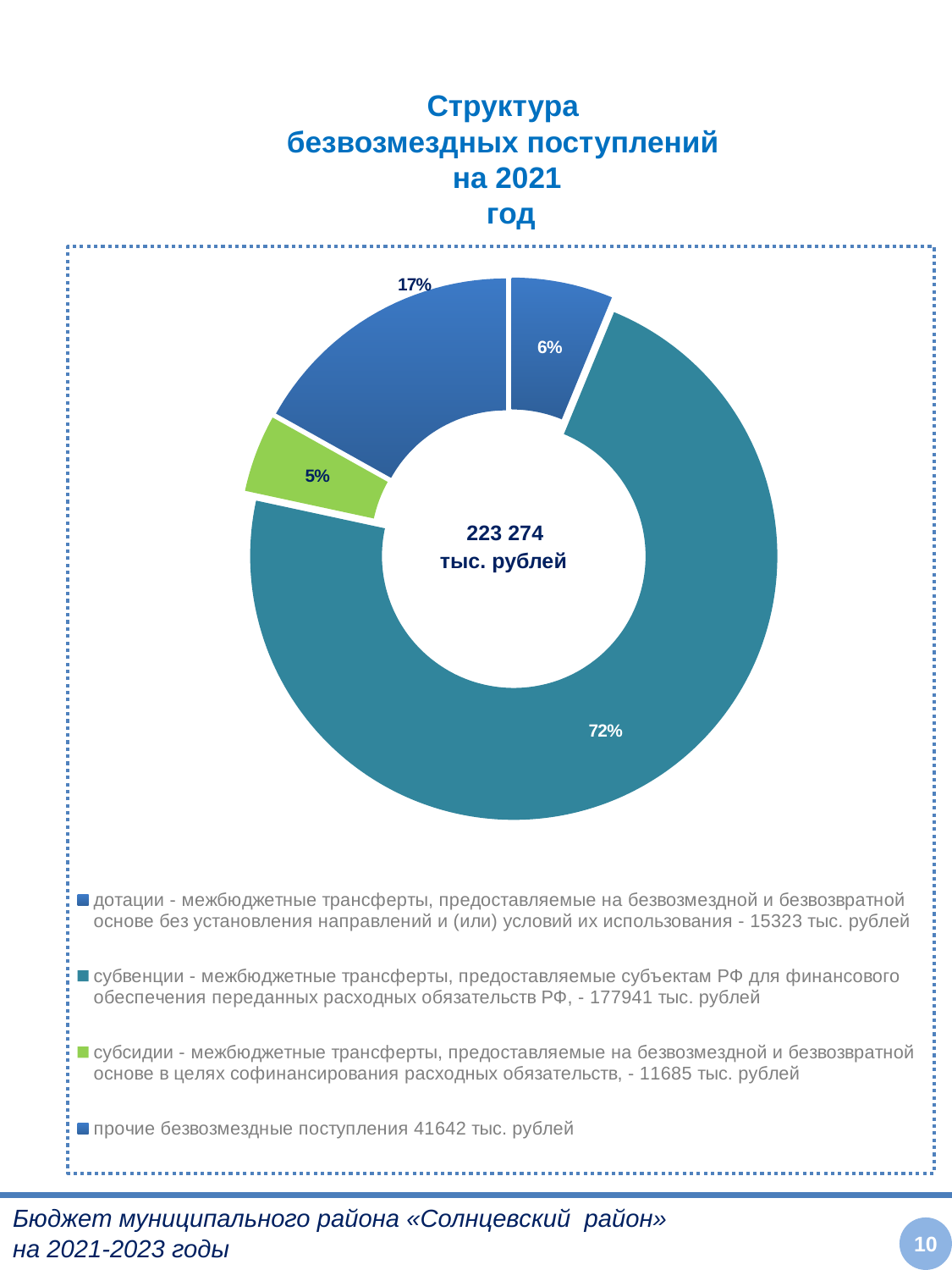
What share of the chart is labelled for дотации (the dark blue slice at the top)? 6% What share of the chart is labelled for субвенции (the teal slice)? 72% What share of the chart is labelled for субсидии (the green slice)? 5% How many slices does the doughnut chart have? 4 What is the difference in percentage points between the субвенции slice and the прочие безвозмездные поступления slice? 55 percentage points What kind of chart is shown on the slide? Pie (doughnut) chart What total amount is printed in the centre of the doughnut chart? 223 274 тыс. рублей Which category has the smallest slice in the chart? субсидии Which category has the largest slice in the chart? субвенции According to the legend, what amount is given for субвенции? 177941 тыс. рублей Which slice is larger: прочие безвозмездные поступления or дотации? прочие безвозмездные поступления